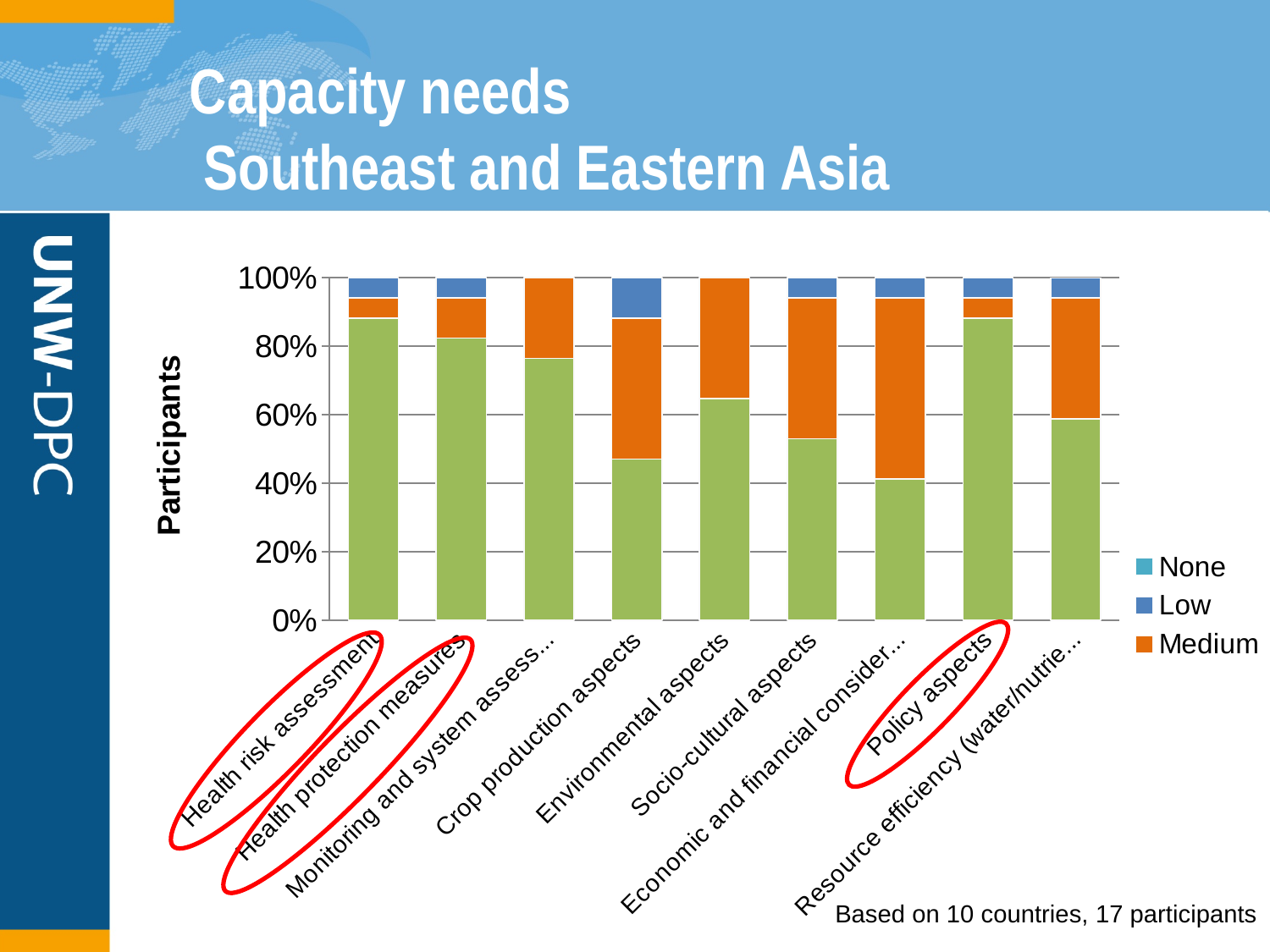
Is the green segment for Crop production aspects greater or less than 60%? less Which category has the largest Low (blue) segment? Crop production aspects What kind of chart is shown on the slide? Stacked bar chart Which category has the smallest green segment? Economic and financial consider... How many series does the visible legend list? 3 What is the label of the vertical axis? Participants Is the green segment for Health risk assessment greater or less than 80%? greater Is the green segment for Policy aspects greater or less than 80%? greater Is the green segment larger for Health risk assessment or for Crop production aspects? Health risk assessment Which three categories are circled in red on the chart? Health risk assessment, Health protection measures, Policy aspects How many categories are plotted along the x axis of the chart? 9